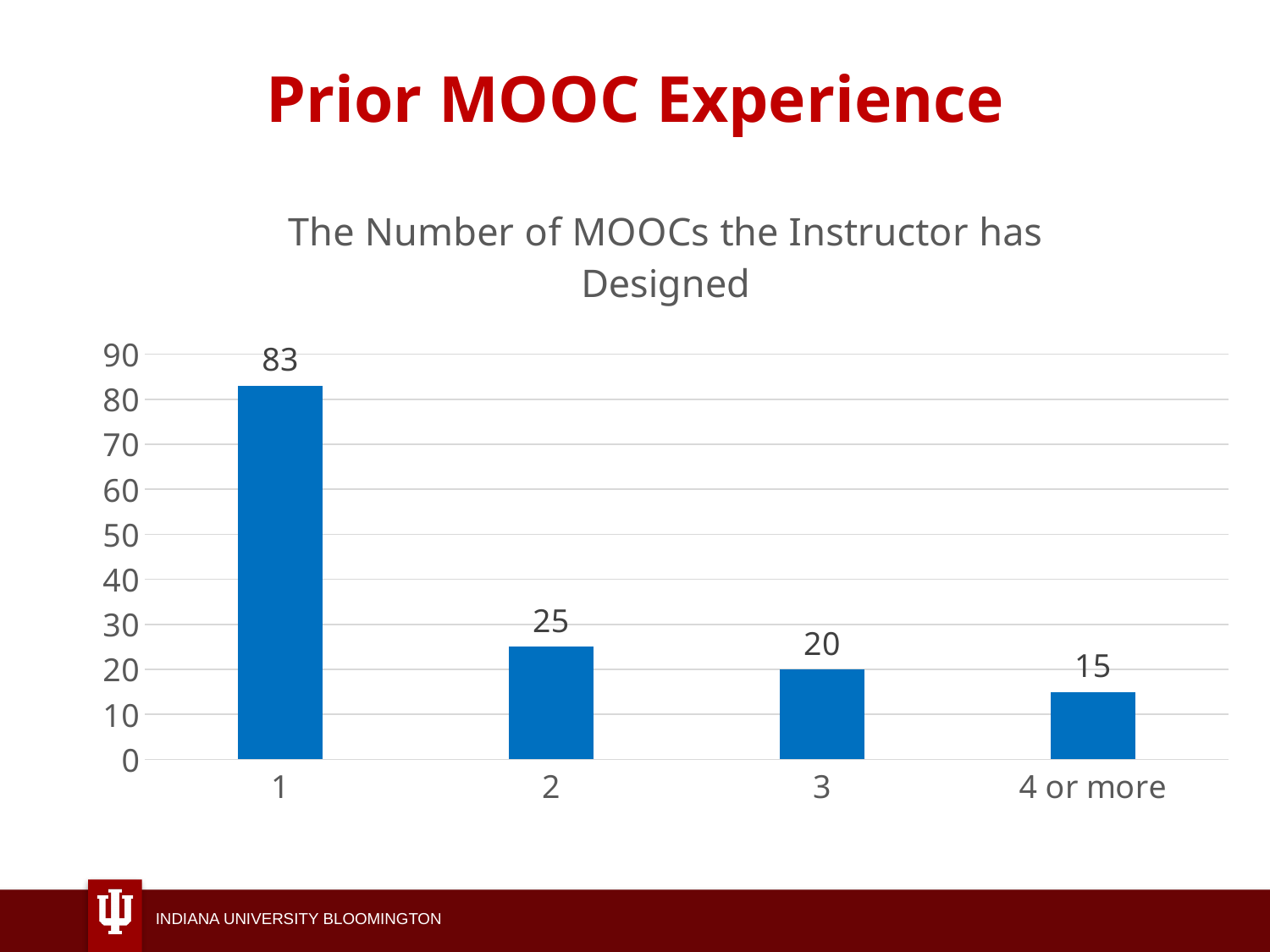
How many categories are shown on the x axis? 4 What is the value for the category "3"? 20 Which is larger, the value for "2" or the value for "3"? 2 What is the value for the category "1"? 83 Do the values rise or fall from left to right along the x axis? fall Is the value for "2" greater or less than 30? less Which category has the highest value? 1 What is the value for the category "4 or more"? 15 What is the difference between the values for "1" and "2"? 58 Which category has the lowest value? 4 or more What is the difference between the values for "3" and "4 or more"? 5 What kind of chart is shown on the slide? bar chart